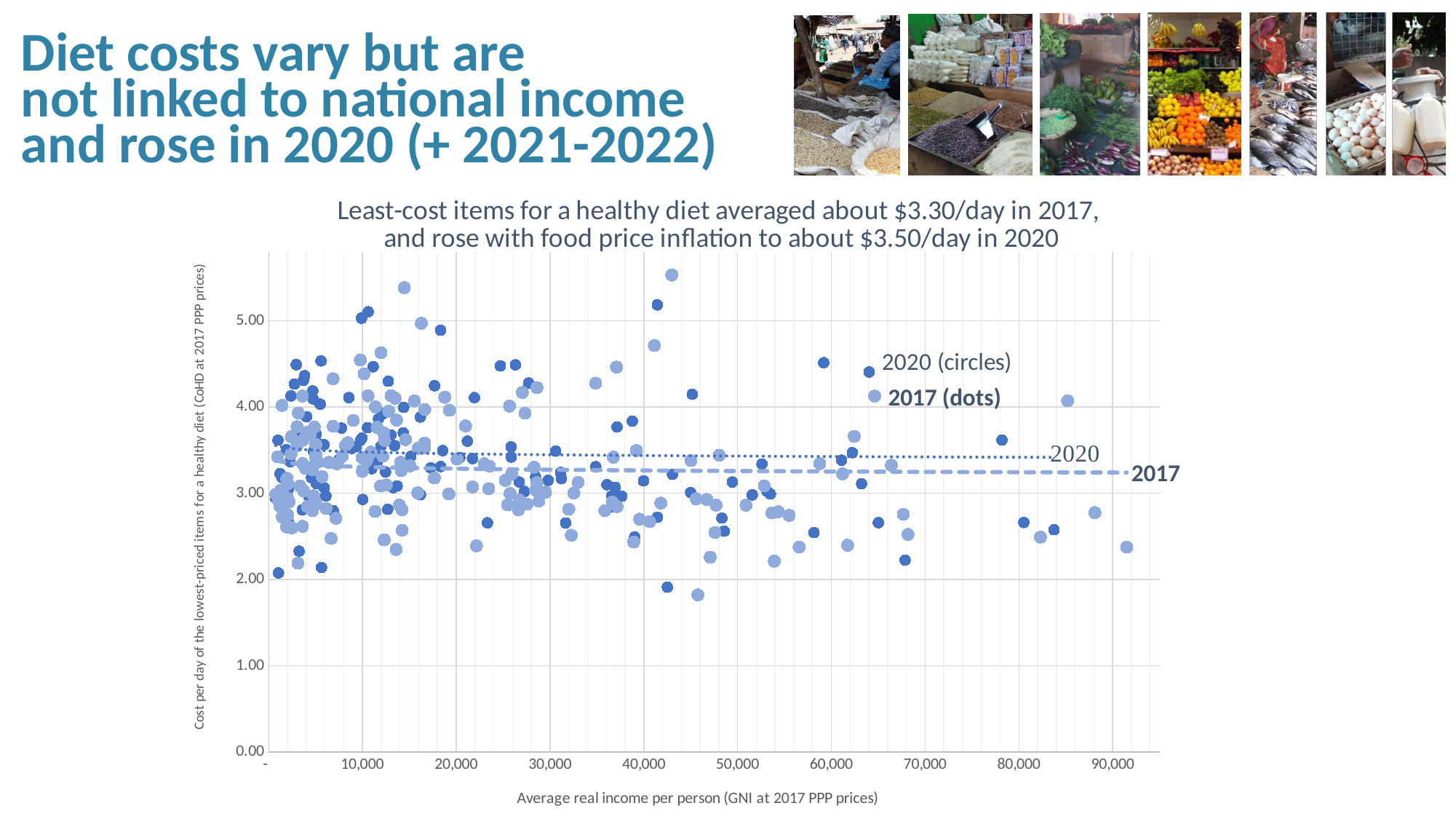
Do the trend lines show diet cost rising, falling, or staying roughly flat as income increases along the x axis? roughly flat According to the chart title, about how much did least-cost items for a healthy diet average per day in 2017? about $3.30/day What kind of chart is shown on the slide? scatter chart Which trend line sits higher on the chart, the 2020 line or the 2017 line? 2020 Which year's data is shown with circles according to the legend? 2020 How many data series does the chart's legend list? 2 Is the 2017 trend line greater or less than 4.00 on the y axis? less Is the highest plotted point on the chart greater or less than 5.00? greater Is the 2020 trend line greater or less than 3.00 on the y axis? greater